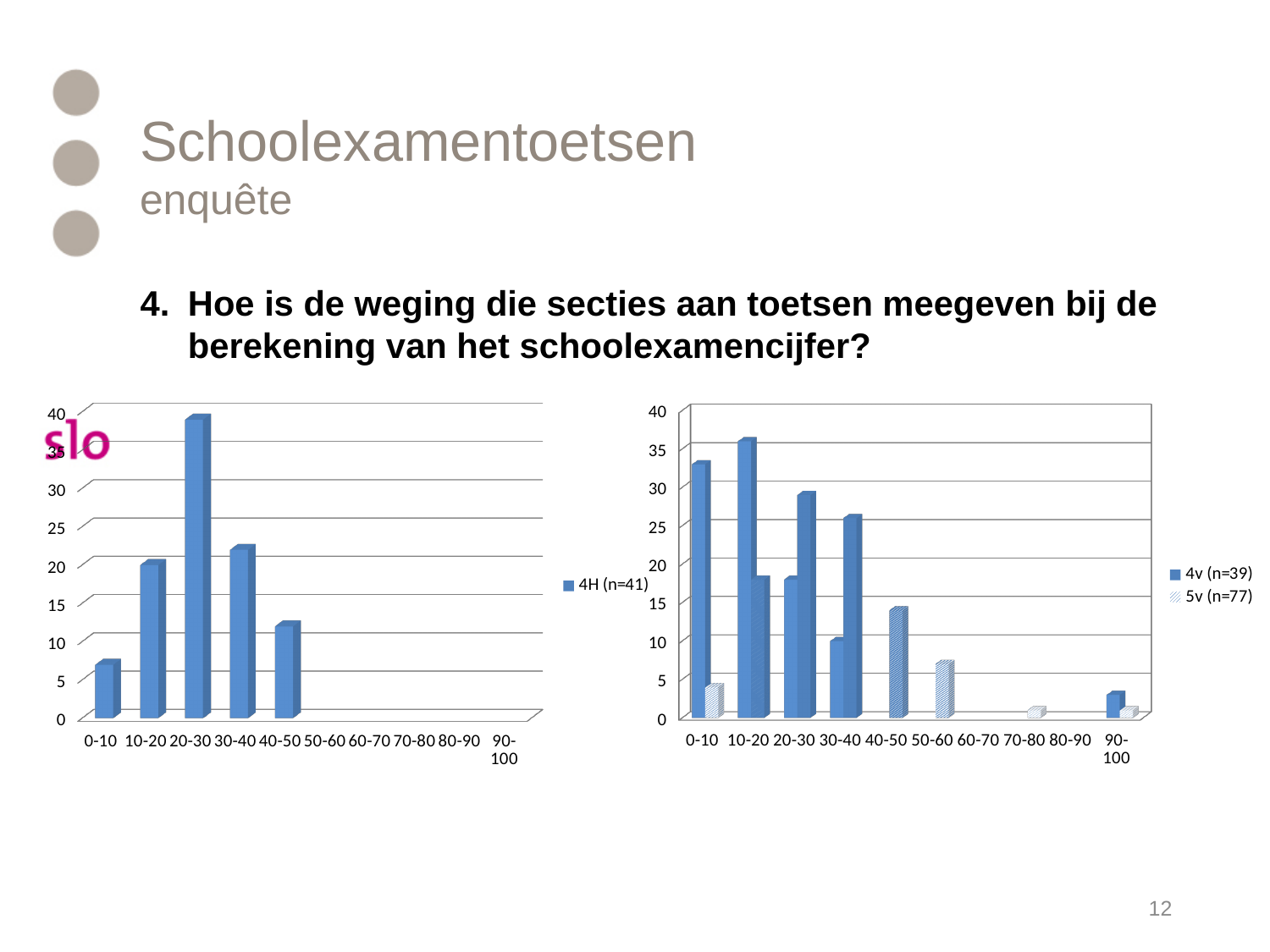
In the left chart, is the value for 20-30 greater or less than 35? greater How many series does the legend of the left chart list? 1 In the right chart, which category has the highest value for 4v (n=39)? 10-20 In the right chart, is the value for 4v (n=39) in 0-10 greater or less than 30? greater In the left chart, is the value for 0-10 greater or less than 10? less How many series does the legend of the right chart list? 2 How many categories are shown on the x axis of the right chart? 10 What kind of chart is the left chart? bar chart In the left chart, which is larger for 4H (n=41): 10-20 or 40-50? 10-20 In the right chart, which is larger in the 30-40 category: 4v (n=39) or 5v (n=77)? 5v (n=77) In the left chart, which category has the highest value for 4H (n=41)? 20-30